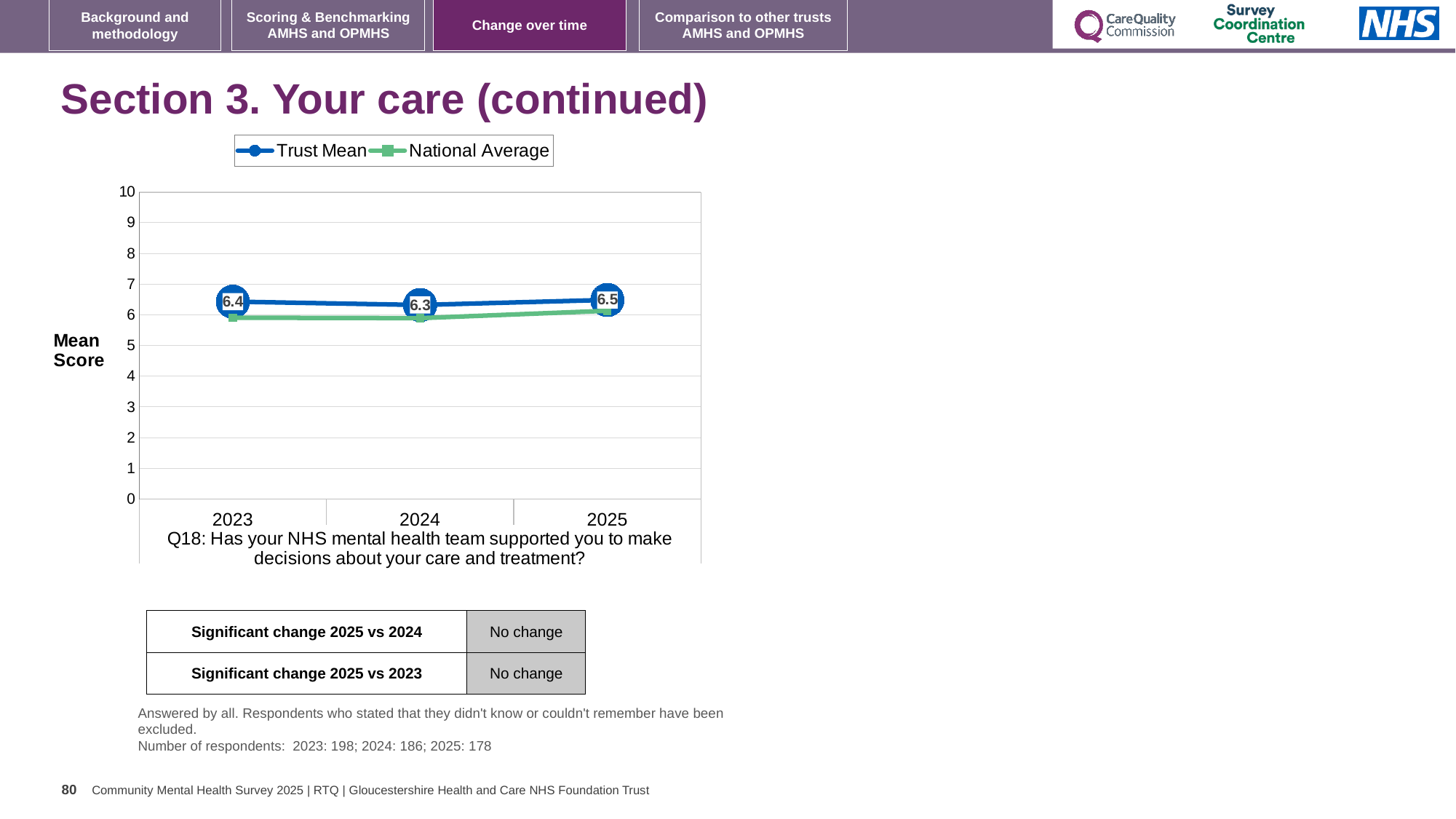
In which year is the Trust Mean highest? 2025 What kind of chart is shown on the slide? line chart How many series does the legend list? 2 What is the Trust Mean score for 2024? 6.3 What is the Trust Mean score for 2025? 6.5 In which year is the Trust Mean lowest? 2024 What is the difference between the Trust Mean in 2025 and in 2024? 0.2 How many years are plotted on the x axis? 3 Which is larger in 2025, the Trust Mean or the National Average? Trust Mean Is the National Average for 2023 greater or less than 7? less What is the Trust Mean score for 2023? 6.4 What is the label on the y axis of the chart? Mean Score